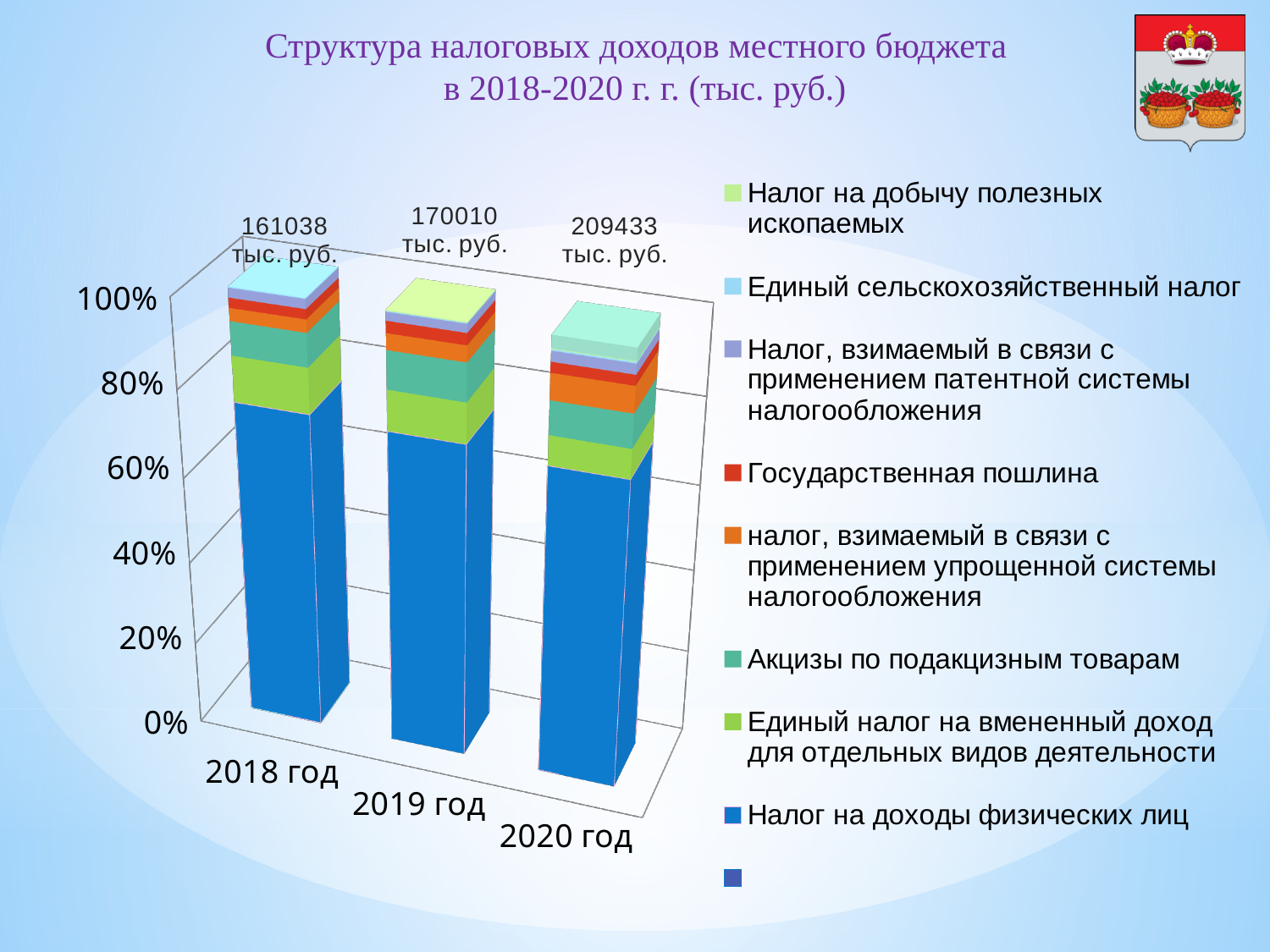
What total is printed above the bar for 2018 год? 161038 тыс. руб. Do the totals printed above the bars rise or fall from 2018 год to 2020 год? Rise Which year has the highest total tax revenue printed above its bar? 2020 год What total is printed above the bar for 2019 год? 170010 тыс. руб. In the 2018 год bar, is the share of Налог на доходы физических лиц greater or less than 60%? greater By how much does the total printed for 2020 год exceed the total printed for 2018 год? 48395 тыс. руб. What kind of chart is shown on the slide? Stacked bar chart What total is printed above the bar for 2020 год? 209433 тыс. руб. Which series forms the bottom (blue) segment of each bar? Налог на доходы физических лиц Which total is larger, the one printed for 2019 год or the one for 2018 год? 2019 год Which year has the lowest total tax revenue printed above its bar? 2018 год How many years (categories) are plotted on the x axis of the chart? 3